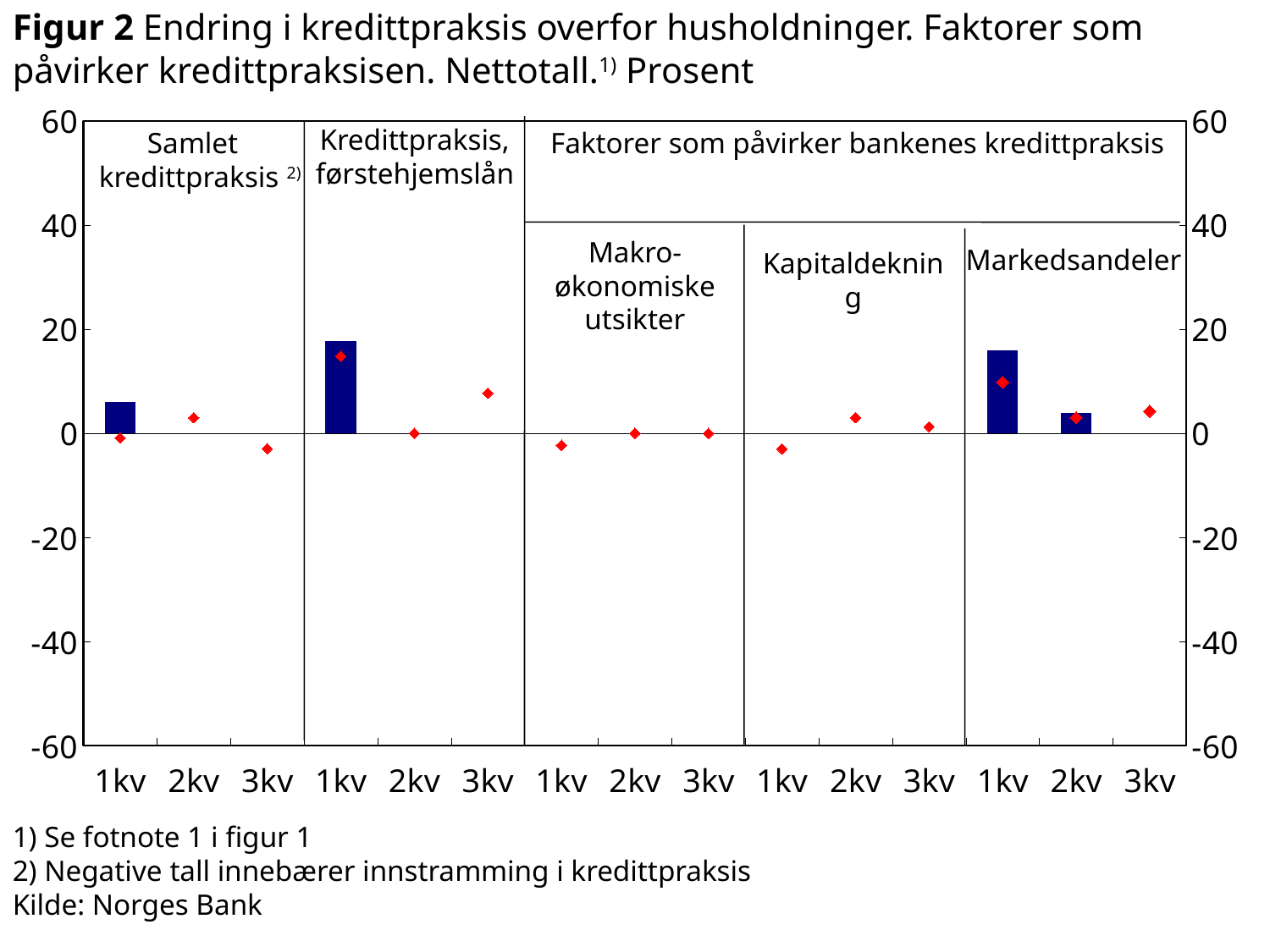
Is the bar for 1kv in the 'Kredittpraksis, førstehjemslån' panel greater or less than 20? less How many panels (sections) is the chart divided into along the x axis? 5 Is the red marker for 1kv in the 'Kapitaldekning' panel greater or less than 0? less Is the bar for 1kv in the 'Markedsandeler' panel greater or less than 0? greater How many quarter categories are shown along the x axis in total? 15 Of the blue bars shown, which one is the lowest? 2kv in Markedsandeler According to footnote 2, what do negative numbers mean? Innstramming i kredittpraksis Which is larger: the red marker for 3kv in 'Samlet kredittpraksis' or the red marker for 3kv in 'Kredittpraksis, førstehjemslån'? 3kv in Kredittpraksis, førstehjemslån What kind of chart is shown on the slide? combination chart with bars and red diamond markers Which is larger: the bar for 1kv in 'Samlet kredittpraksis' or the bar for 1kv in 'Markedsandeler'? 1kv in Markedsandeler In the 'Markedsandeler' panel, do the blue bars rise or fall from 1kv to 2kv? fall